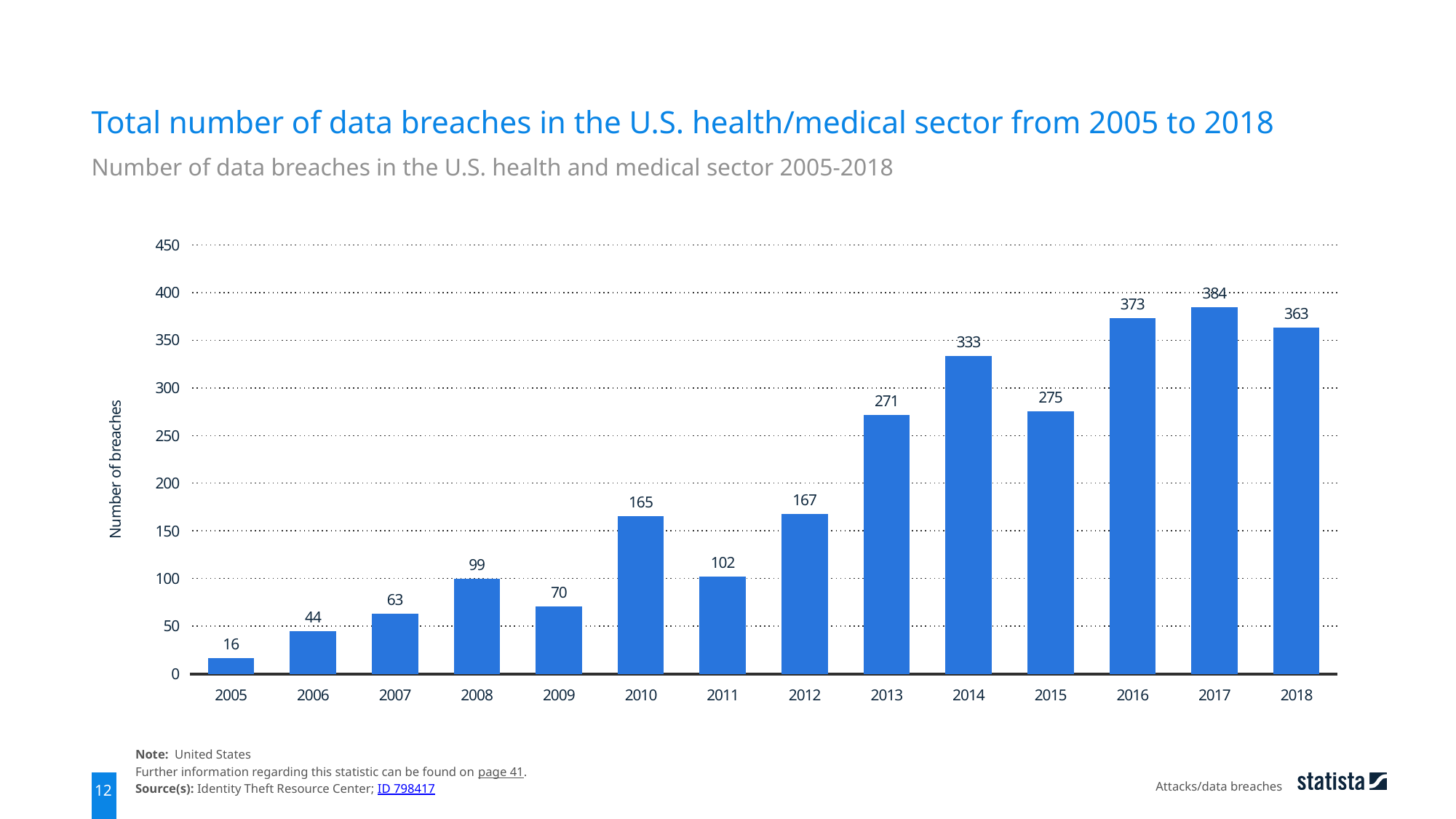
What is the label of the y axis? Number of breaches What kind of chart is shown on the slide? Bar chart What is the number of data breaches in 2015? 275 How many years are shown on the x axis? 14 What is the number of data breaches in 2010? 165 Which year had more data breaches, 2008 or 2009? 2008 What is the difference in the number of data breaches between 2014 and 2013? 62 Which year has the highest number of data breaches? 2017 What is the difference in the number of data breaches between 2017 and 2018? 21 Is the value for 2016 greater or less than 350? greater Which year has the lowest number of data breaches? 2005 What is the number of data breaches in 2005? 16